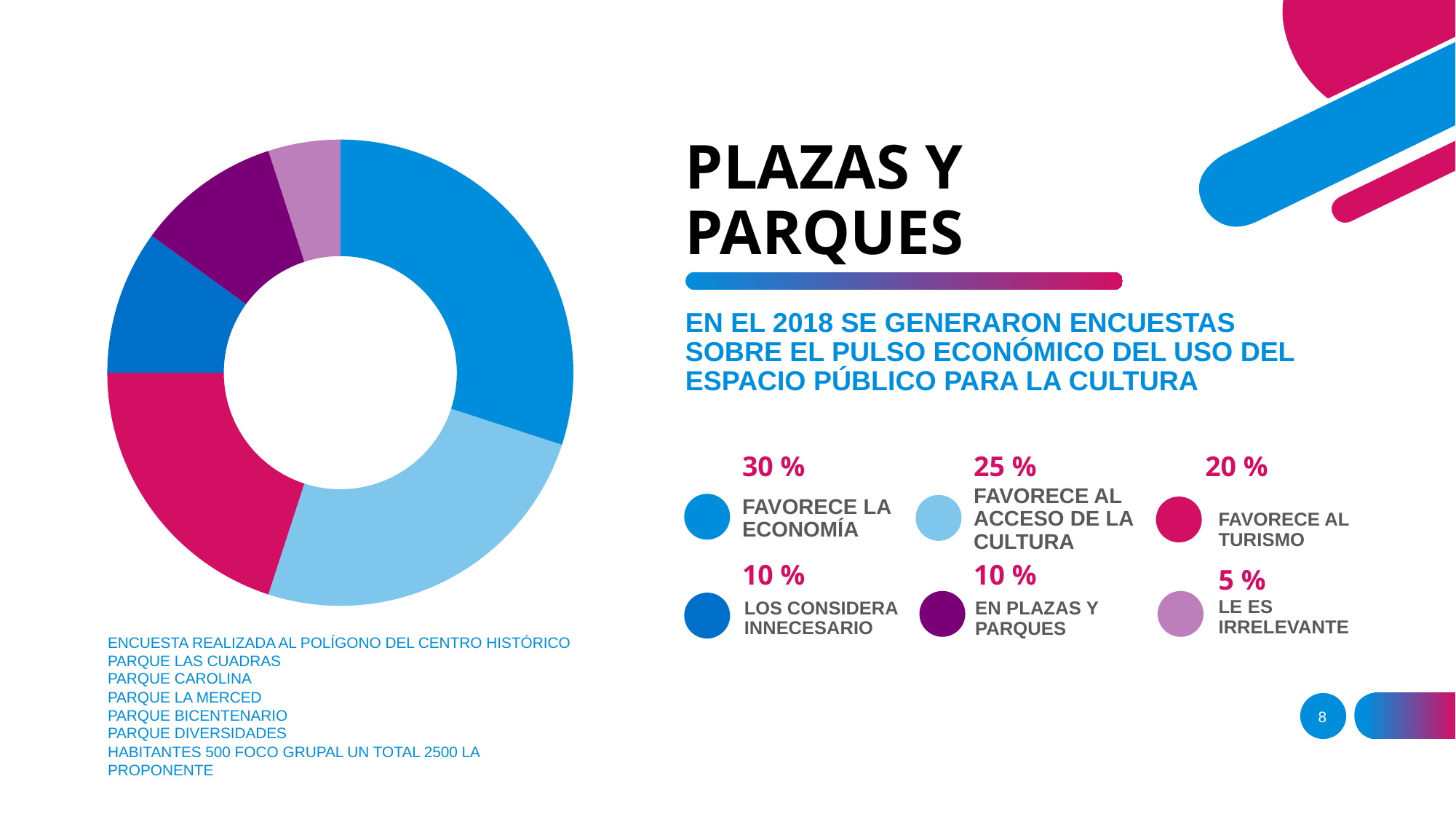
What percentage corresponds to "Favorece la economía"? 30 % Which category has the largest share of the donut chart? Favorece la economía What percentage corresponds to "Favorece al acceso de la cultura"? 25 % Which category has the smallest share of the donut chart? Le es irrelevante How many slices does the donut chart have? 6 What percentage corresponds to "Favorece al turismo"? 20 % What colour is the slice for "Favorece al turismo"? Magenta/pink What percentage corresponds to "Le es irrelevante"? 5 % Which is larger, the share for "Favorece al acceso de la cultura" or the share for "Los considera innecesario"? Favorece al acceso de la cultura What kind of chart is shown on the slide? Donut (pie) chart Which two categories share the same percentage of 10 %? Los considera innecesario and En plazas y parques What is the difference in percentage points between "Favorece la economía" and "Favorece al turismo"? 10